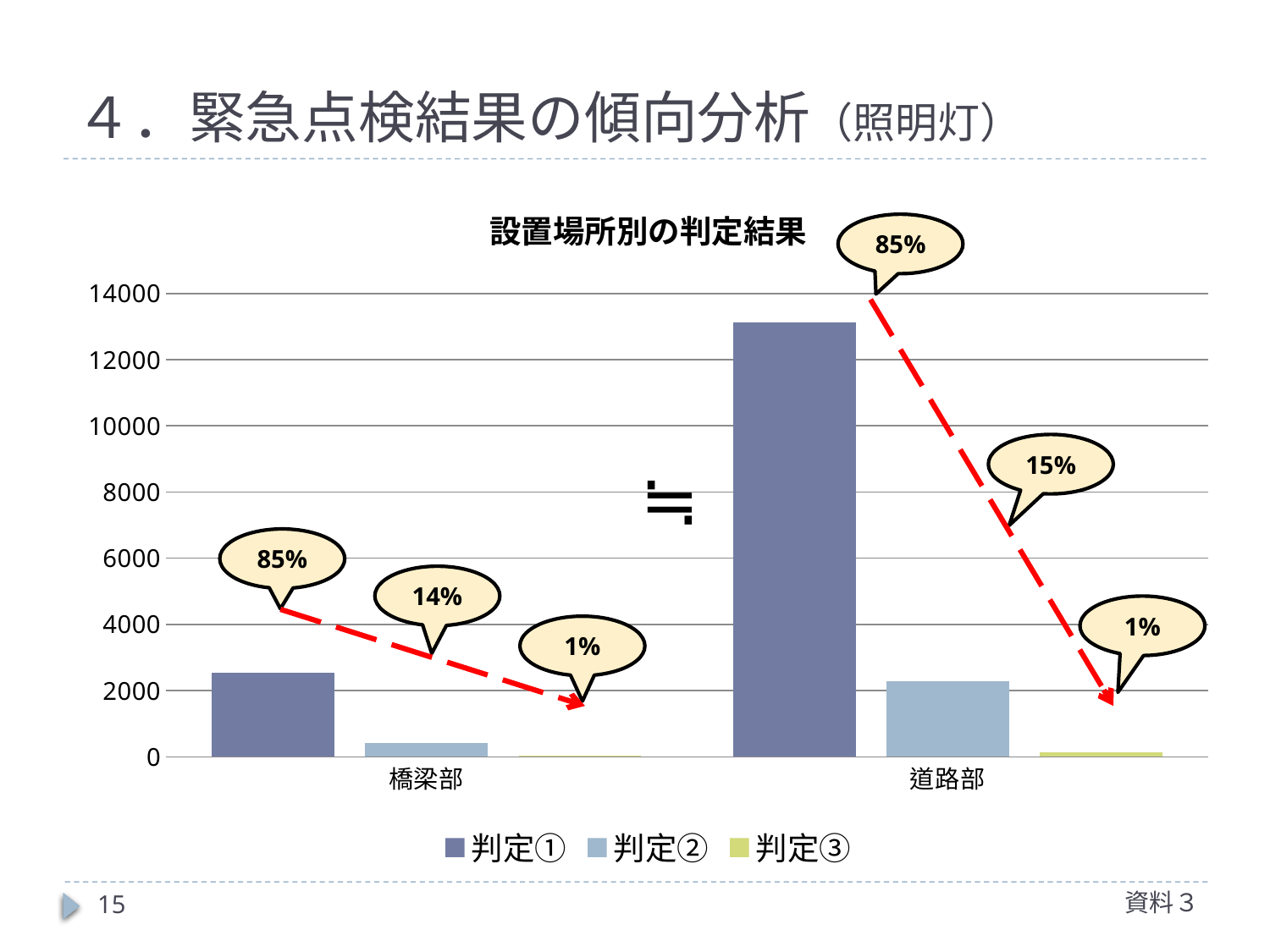
How many categories are shown on the x axis? 2 What type of chart is shown on the slide? bar chart What is the title of the chart? 設置場所別の判定結果 What percentage is shown in the callout for 判定② in 道路部? 15% Which category has the tallest 判定① bar? 道路部 Is the value for 判定① in 道路部 greater or less than 12000? greater Is the value for 判定② in 道路部 greater or less than 4000? less What percentage is shown in the callout for 判定② in 橋梁部? 14% How many series does the legend list? 3 Is the value for 判定① in 橋梁部 greater or less than 4000? less Which is larger: 判定② in 橋梁部 or 判定② in 道路部? 判定② in 道路部 Which series has the lowest bar in the 橋梁部 category? 判定③